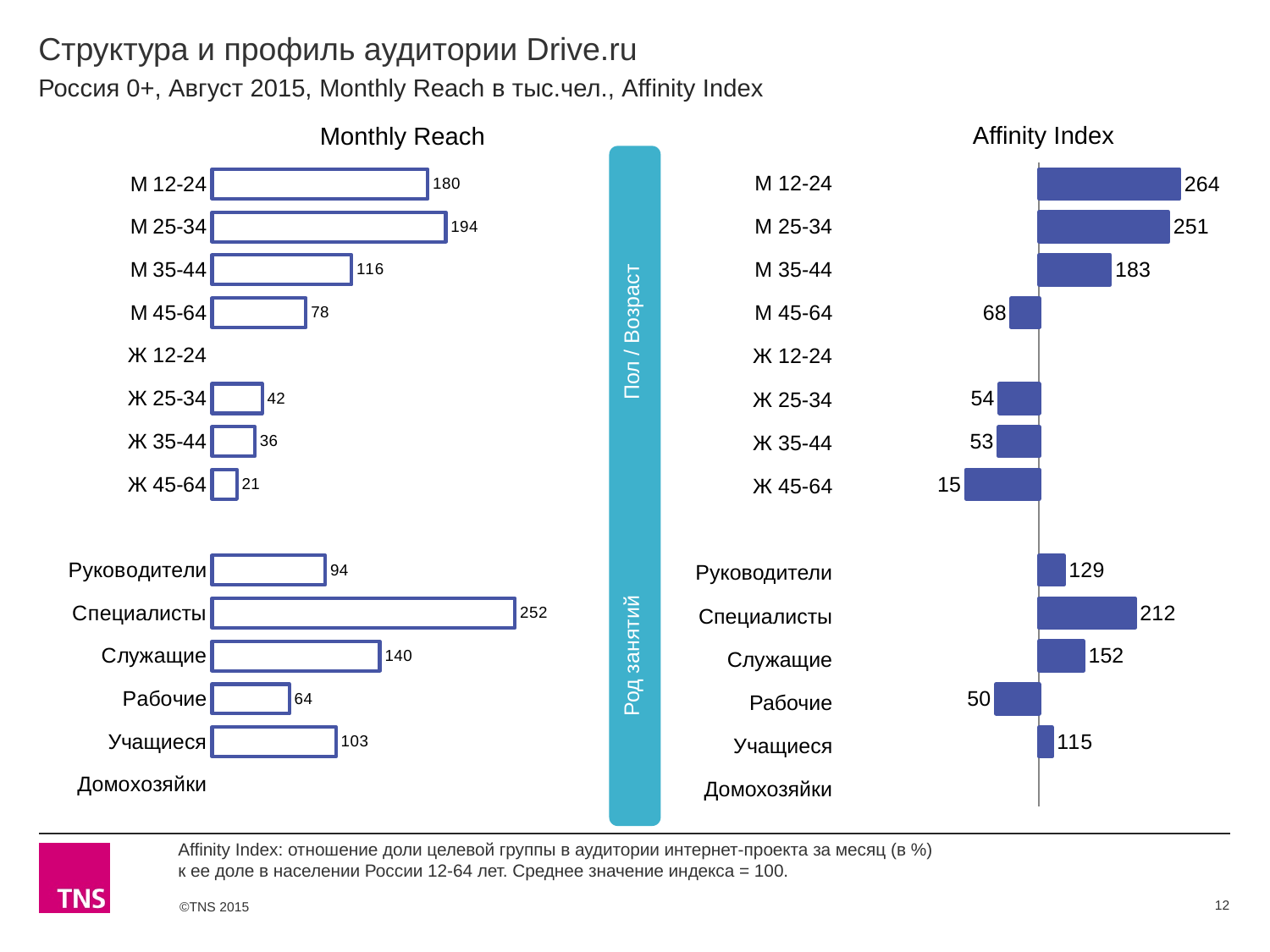
In the Monthly Reach chart, what is the value for Учащиеся? 103 In the Affinity Index chart, which category has the lowest value? Ж 45-64 In the Affinity Index chart, which is larger: the value for Рабочие or the value for Учащиеся? Учащиеся In the Monthly Reach chart, what is the difference between the values for М 12-24 and М 45-64? 102 What type of chart is the Monthly Reach chart? Bar chart In the Affinity Index chart, what is the value for М 12-24? 264 In the Affinity Index chart, what is the difference between the values for М 25-34 and М 35-44? 68 In the Monthly Reach chart, what is the value for М 25-34? 194 In the Affinity Index chart, what is the value for Специалисты? 212 In the Monthly Reach chart, what is the value for Ж 45-64? 21 In the Affinity Index chart, which is larger: the value for Руководители or the value for Служащие? Служащие In the Monthly Reach chart, which category has the highest value? Специалисты